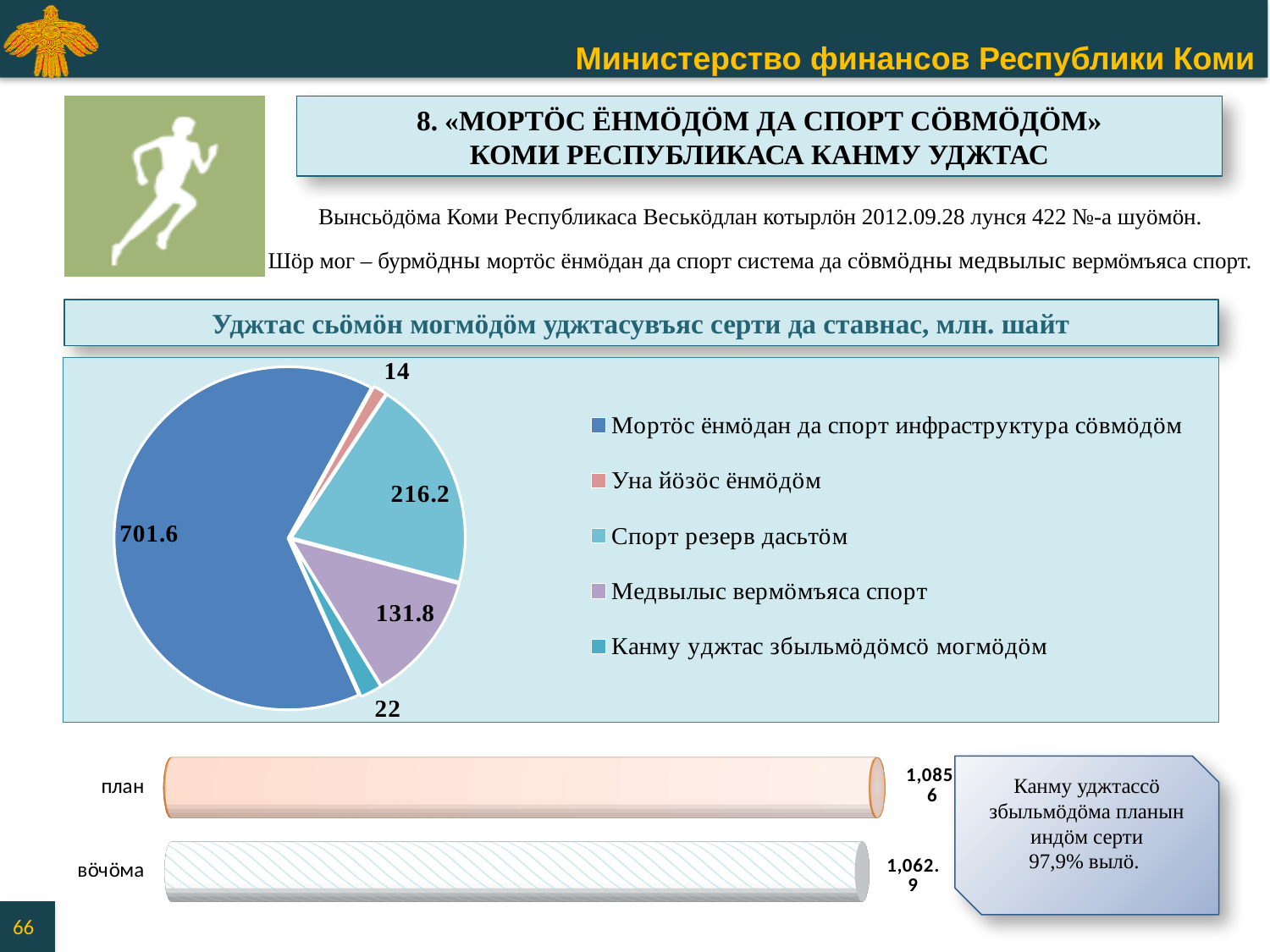
In the lower bar chart, what is the value for вöчöма? 1,062.9 In the pie chart, what is the value for Мортöс ёнмöдан да спорт инфраструктура сöвмöдöм? 701.6 In the pie chart, which is larger: Канму уджтас збыльмöдöмсö могмöдöм or Уна йöзöс ёнмöдöм? Канму уджтас збыльмöдöмсö могмöдöм In the pie chart, which category has the largest slice? Мортöс ёнмöдан да спорт инфраструктура сöвмöдöм What kind of chart is the upper chart on the slide? pie chart In the pie chart, what is the value for Спорт резерв дасьтöм? 216.2 In the pie chart, which category has the smallest slice? Уна йöзöс ёнмöдöм In the pie chart, what is the value for Уна йöзöс ёнмöдöм? 14 In the lower bar chart, which bar is longer: план or вöчöма? план In the pie chart, what is the value for Медвылыс вермöмъяса спорт? 131.8 How many categories does the pie chart's legend list? 5 In the pie chart, what is the difference between Спорт резерв дасьтöм and Медвылыс вермöмъяса спорт? 84.4